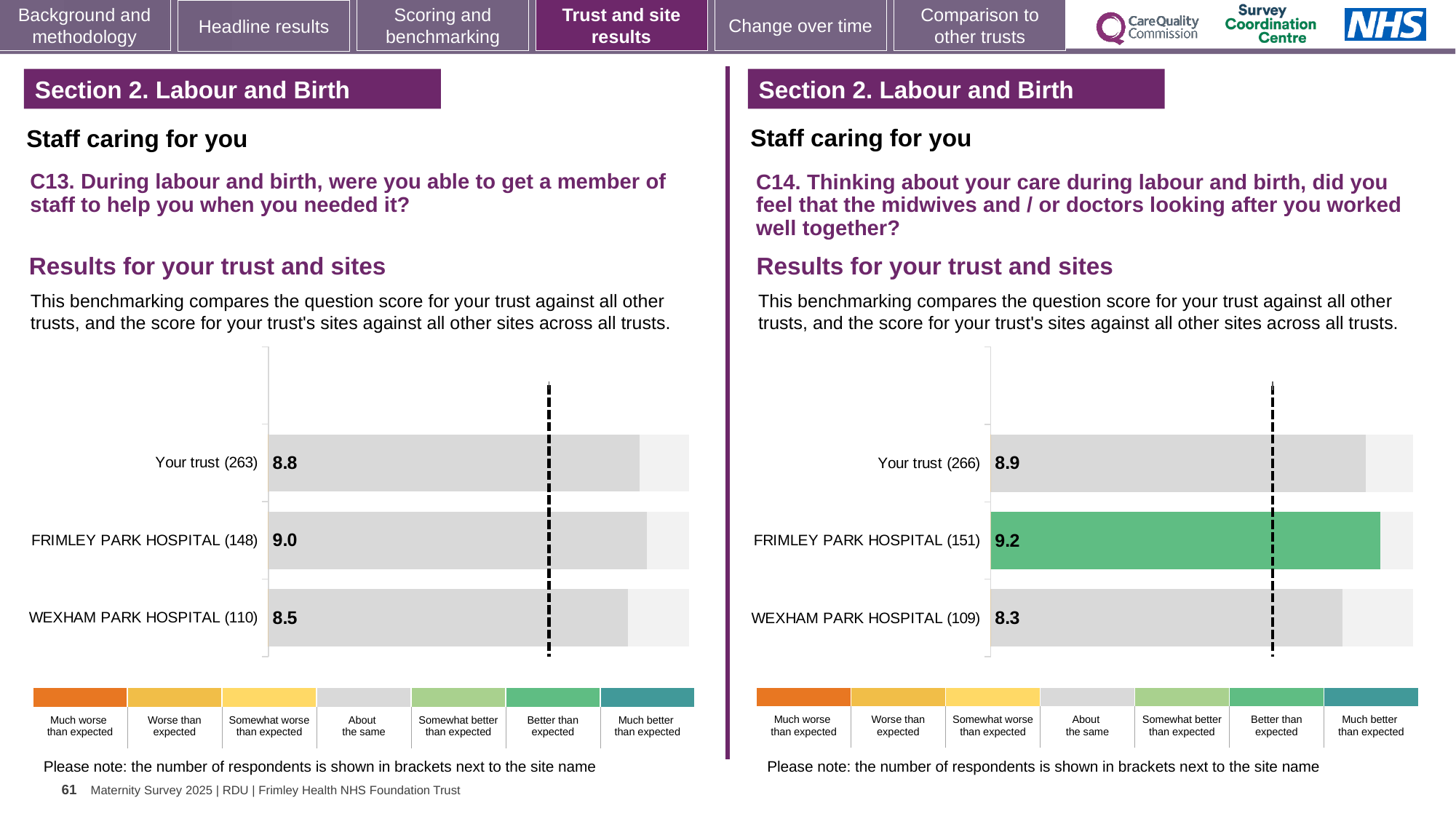
In the C13 chart on the left, what is the difference between the Frimley Park Hospital score and the Wexham Park Hospital score? 0.5 In the C14 chart on the right, which benchmark category does the green bar for Frimley Park Hospital indicate? Better than expected In the C14 chart on the right, what is the score for Wexham Park Hospital? 8.3 In the C14 chart on the right, what is the difference between the Frimley Park Hospital score and the Wexham Park Hospital score? 0.9 In the C14 chart on the right, what is the score for Frimley Park Hospital? 9.2 In the C13 chart on the left, what is the score for Your trust? 8.8 In the C13 chart on the left, how many respondents are shown in brackets for Your trust? 263 In the C13 chart on the left, what is the score for Wexham Park Hospital? 8.5 In the C14 chart on the right, what is the score for Your trust? 8.9 In the C13 chart on the left, which site or trust has the lowest score? Wexham Park Hospital In the C13 chart on the left, what is the score for Frimley Park Hospital? 9.0 In the C14 chart on the right, which site or trust has the highest score? Frimley Park Hospital